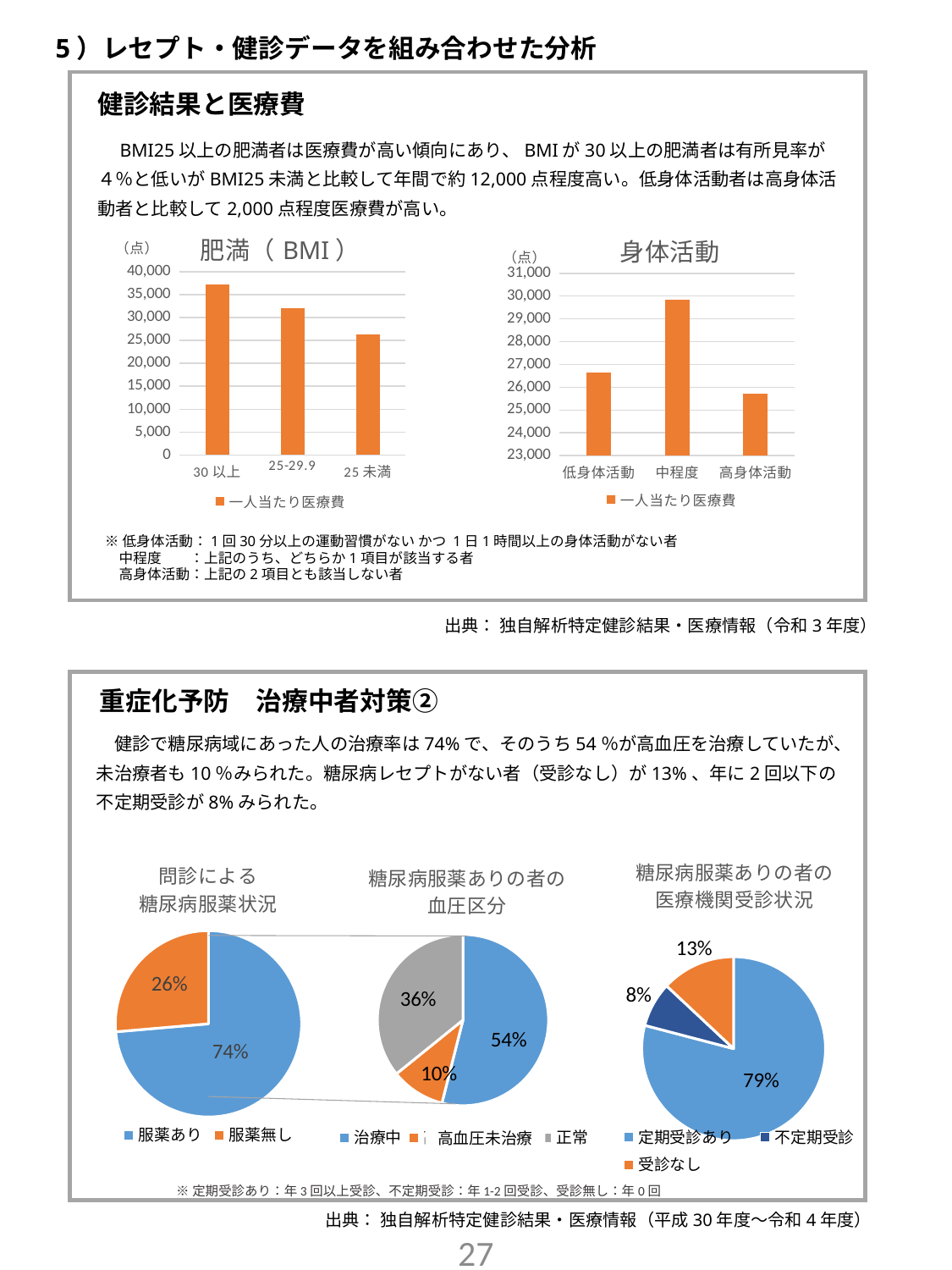
In the 糖尿病服薬ありの者の血圧区分 pie chart, what is the value for 高血圧未治療? 10% In the 肥満（BMI） chart, which category has the highest 一人当たり医療費? 30 以上 In the 肥満（BMI） chart, is the value for 25-29.9 greater or less than 35,000? less In the 肥満（BMI） chart, is the value for 25 未満 greater or less than 25,000? greater In the 身体活動 chart, is the value for 低身体活動 greater or less than 26,000? greater What kind of chart is the 肥満（BMI） chart? bar chart In the 糖尿病服薬ありの者の医療機関受診状況 pie chart, what is the difference between 定期受診あり and 受診なし? 66% In the 糖尿病服薬ありの者の血圧区分 pie chart, which is larger, 治療中 or 正常? 治療中 In the 身体活動 chart, which category has the lowest 一人当たり医療費? 高身体活動 In the 身体活動 chart, which category has the highest 一人当たり医療費? 中程度 In the 問診による糖尿病服薬状況 pie chart, what share is 服薬あり? 74% How many categories are shown in the 身体活動 chart? 3